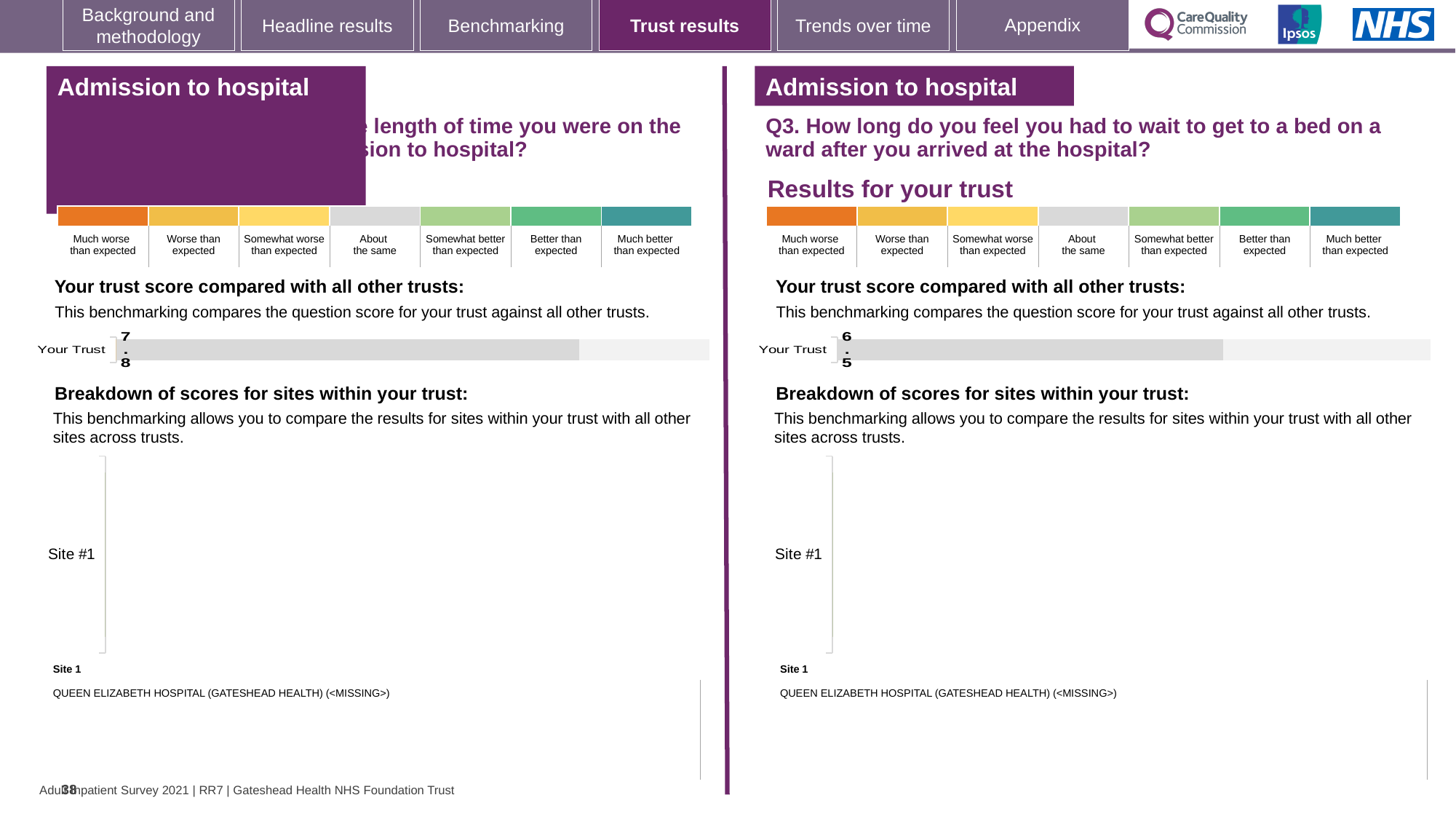
On the right-hand chart for Q3 (wait to get to a bed on a ward), what is the score shown for Your Trust? 6.5 What is the difference between the Your Trust score on the left-hand chart and the Your Trust score on the right-hand Q3 chart? 1.3 How many categories are plotted in the 'Your trust score compared with all other trusts' chart on the left-hand panel? 1 Is the Your Trust score on the left-hand chart greater or less than 7? greater What is the label of the single category plotted in the trust score chart on the right-hand Q3 panel? Your Trust Is the Your Trust score on the right-hand Q3 chart greater or less than 7? less What kind of chart is used to show the Your Trust score on the right-hand Q3 panel? bar chart How many rating bands are shown in the colour scale above the trust score chart on the right-hand Q3 panel? 7 Which chart shows the higher Your Trust score, the left-hand chart or the right-hand Q3 chart? the left-hand chart On the left-hand chart, what is the score shown for Your Trust? 7.8